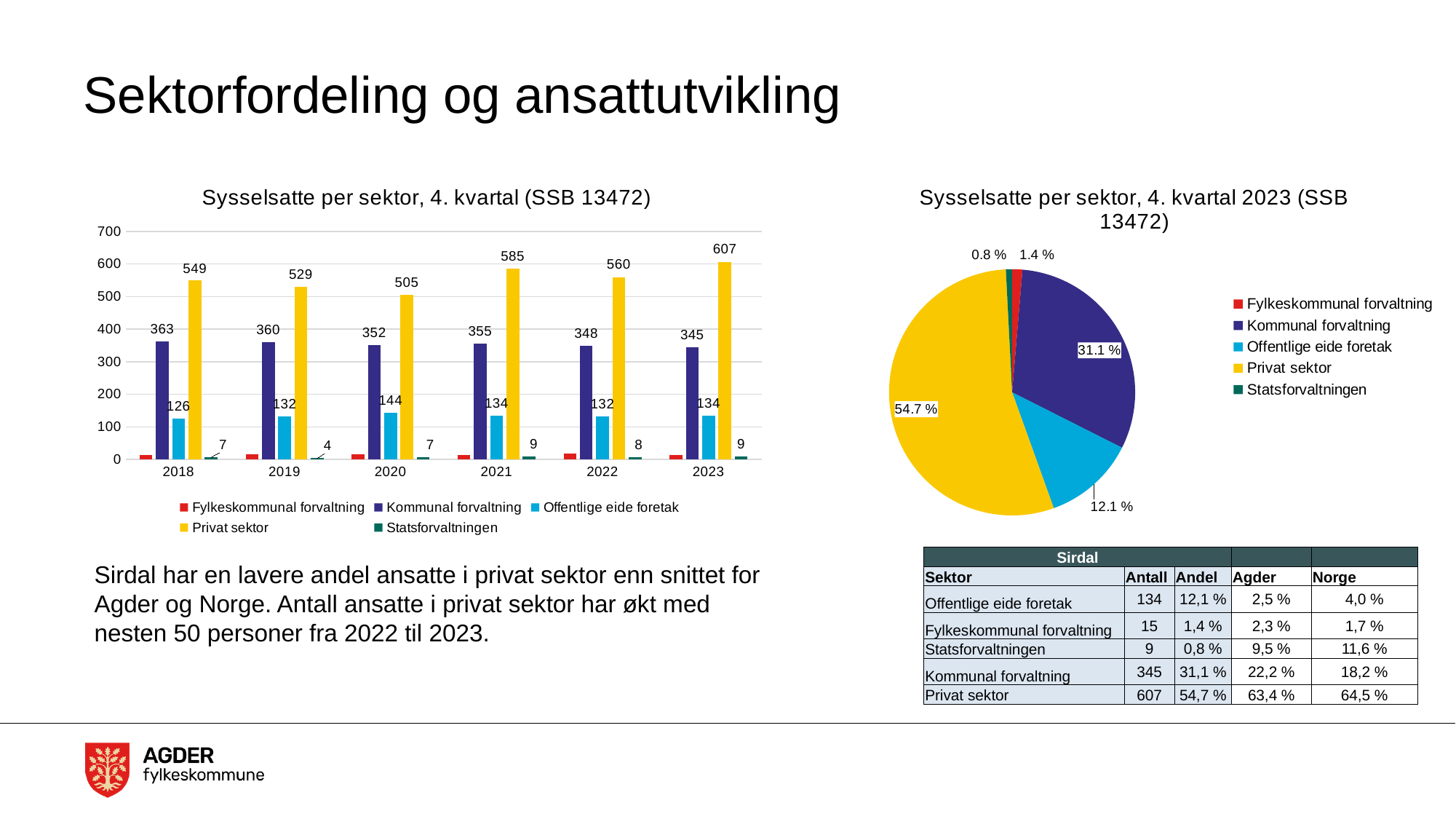
In the bar chart on the left, which year has the larger value for Offentlige eide foretak, 2019 or 2020? 2020 How many series does the legend of the bar chart on the left list? 5 How many years are shown on the x axis of the bar chart on the left? 6 In the bar chart on the left, in which year is the Statsforvaltningen value lowest? 2019 In the bar chart on the left, do the Kommunal forvaltning values rise or fall from 2018 to 2023? fall What kind of chart is the chart on the left of the slide? bar chart In the bar chart on the left, what is the difference between the Privat sektor values for 2023 and 2022? 47 In the bar chart on the left, in which year is the Privat sektor value highest? 2023 In the bar chart on the left, what is the value for Kommunal forvaltning in 2018? 363 In the pie chart 'Sysselsatte per sektor, 4. kvartal 2023 (SSB 13472)', what share does Privat sektor have? 54.7 % In the bar chart 'Sysselsatte per sektor, 4. kvartal (SSB 13472)', what is the value for Privat sektor in 2023? 607 In the pie chart on the right, which sector has the largest slice? Privat sektor